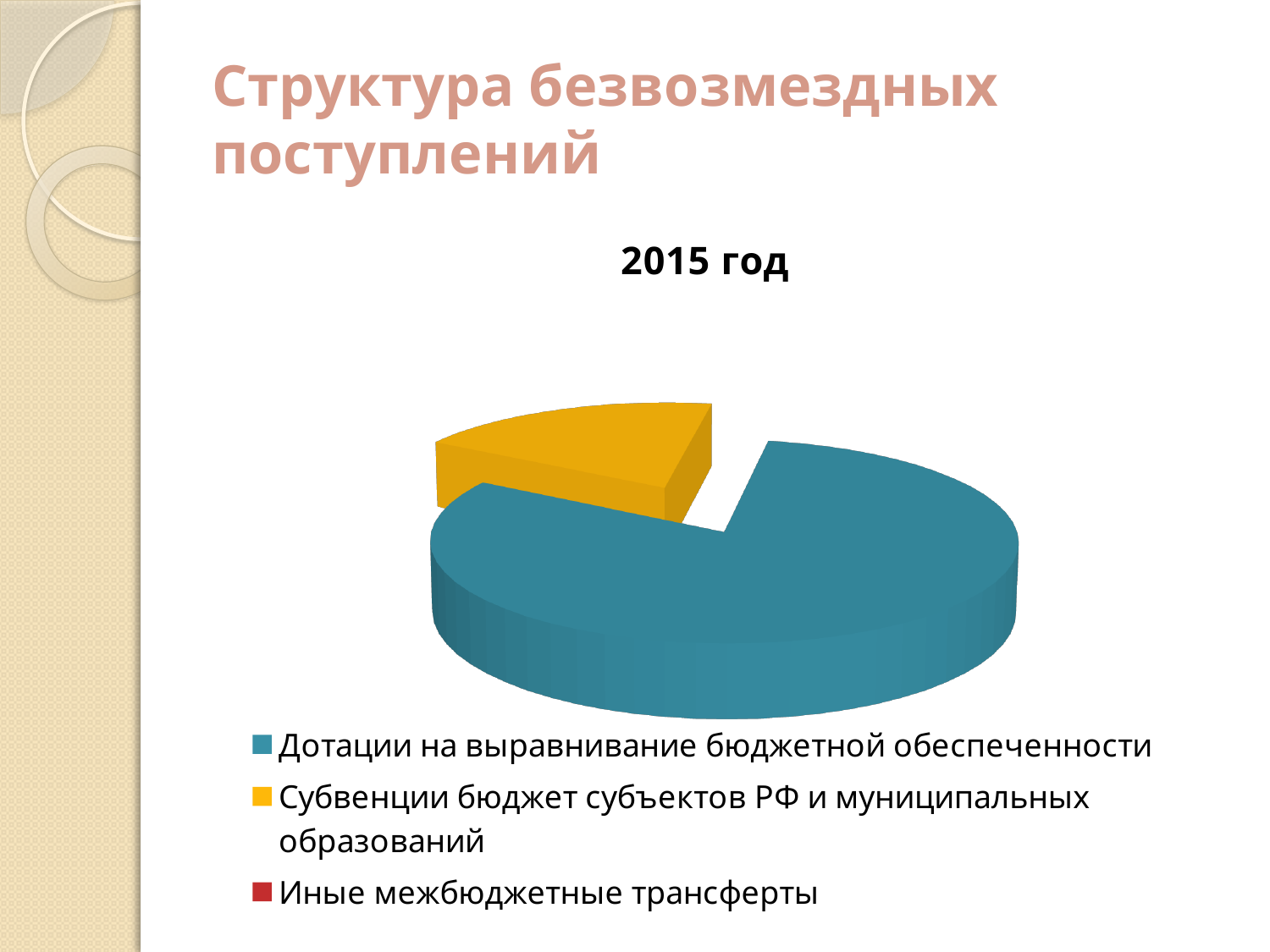
Which colour represents Субвенции бюджет субъектов РФ и муниципальных образований in the chart? yellow Which is larger: the slice for Дотации на выравнивание бюджетной обеспеченности or the slice for Субвенции бюджет субъектов РФ и муниципальных образований? Дотации на выравнивание бюджетной обеспеченности How many slices are visibly drawn in the pie? 2 How many entries does the chart legend list? 3 Which category has the largest slice of the pie? Дотации на выравнивание бюджетной обеспеченности What kind of chart is shown on the slide? pie chart What is the title of the chart? 2015 год Does the slice for Дотации на выравнивание бюджетной обеспеченности take up more or less than half of the pie? more